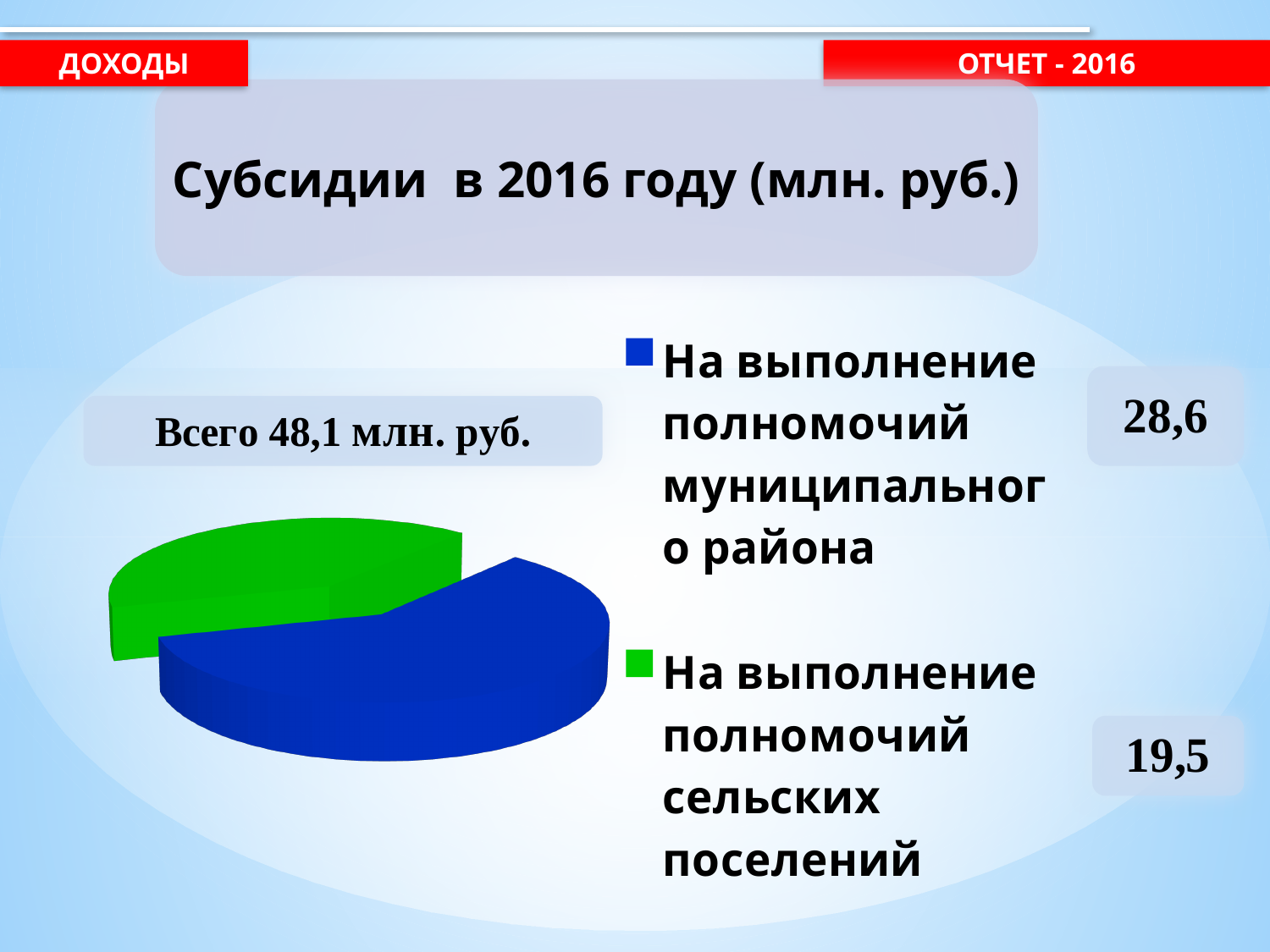
Which category has the smallest slice of the pie? На выполнение полномочий сельских поселений What is the title of the chart on the slide? Субсидии в 2016 году (млн. руб.) Which category has the largest slice of the pie? На выполнение полномочий муниципального района What total amount of subsidies is stated on the slide? 48,1 млн. руб. What is the value for "На выполнение полномочий муниципального района"? 28,6 How many slices does the pie chart have? 2 What is the value for "На выполнение полномочий сельских поселений"? 19,5 Which is larger: the value for "На выполнение полномочий сельских поселений" or the value for "На выполнение полномочий муниципального района"? На выполнение полномочий муниципального района How many entries does the legend list? 2 What kind of chart is shown on the slide? pie chart What colour is the slice for "На выполнение полномочий сельских поселений"? green What is the difference between the value for "На выполнение полномочий муниципального района" and the value for "На выполнение полномочий сельских поселений"? 9,1